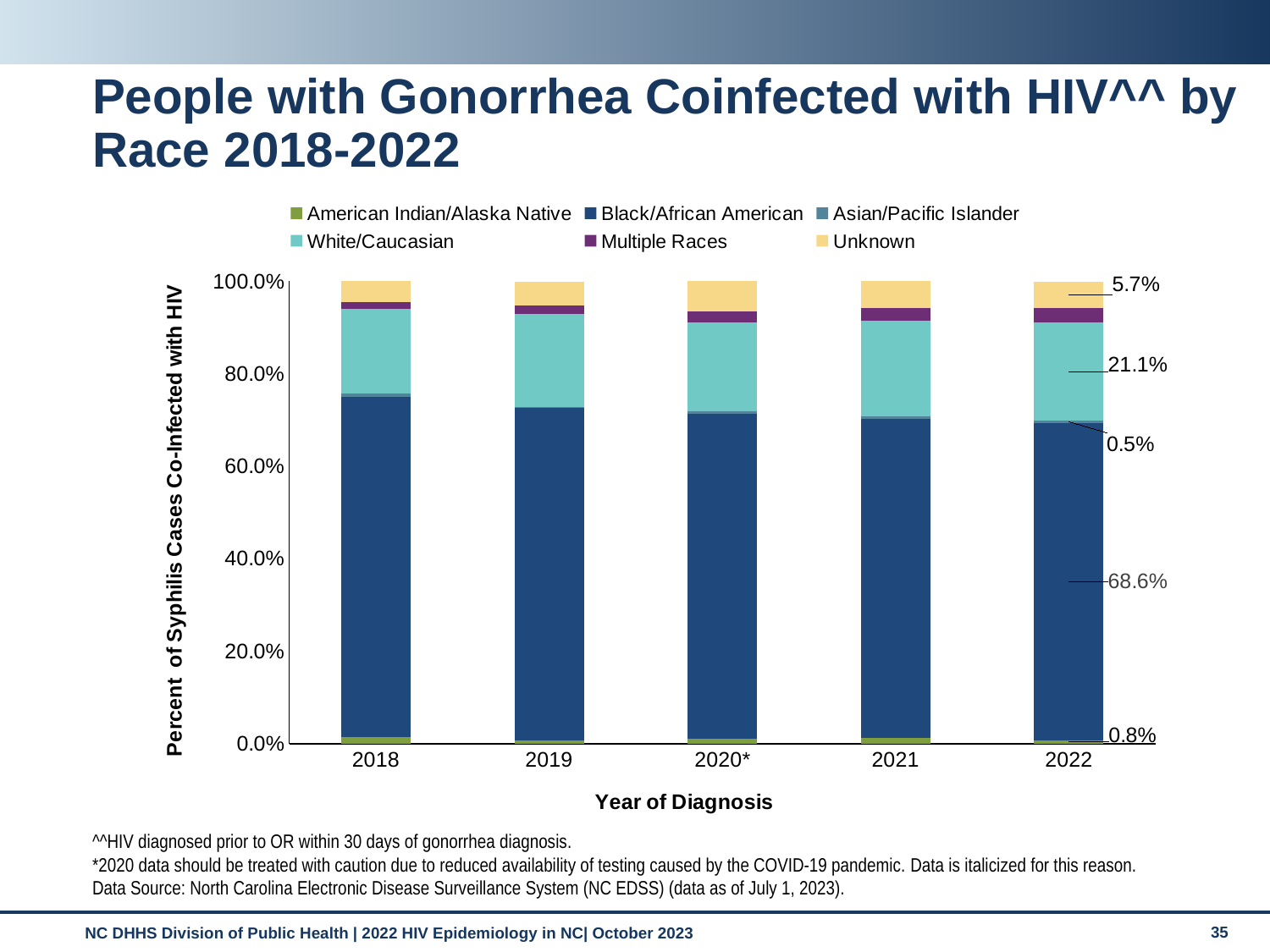
How many years are shown on the x axis of the chart? 5 How many series does the legend list? 6 What is the value for Asian/Pacific Islander in 2022? 0.5% What is the value for American Indian/Alaska Native in 2022? 0.8% What is the value for Black/African American in 2022? 68.6% Is the value for Black/African American in 2018 greater or less than 60.0%? greater What is the label of the x axis? Year of Diagnosis What is the value for Unknown in 2022? 5.7% What is the difference between the White/Caucasian and Unknown values in 2022? 15.4% What type of chart is shown on the slide? Stacked bar chart Which race group has the largest share in 2022? Black/African American What is the value for White/Caucasian in 2022? 21.1%